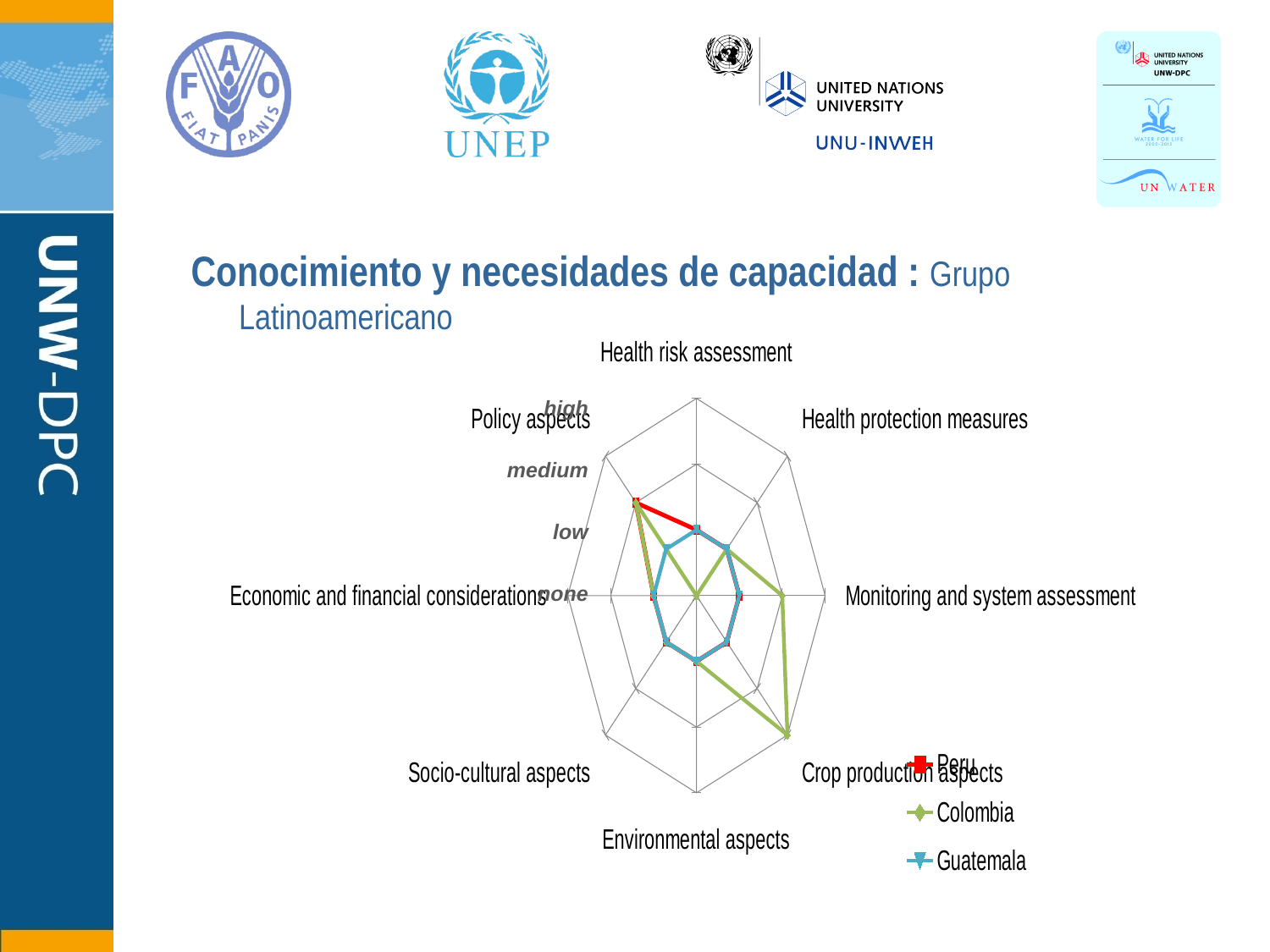
For Colombia, which category has the highest value? Crop production aspects Which countries are listed in the chart legend? Peru, Colombia, Guatemala Which category is plotted at the bottom of the radar chart? Environmental aspects How many categories (axes) does the radar chart have? 8 How many series does the chart legend list? 3 What kind of chart is shown on the slide? Radar chart Which category is plotted at the top of the radar chart? Health risk assessment On Monitoring and system assessment, which is larger: the value for Colombia or the value for Guatemala? Colombia On Policy aspects, which is larger: the value for Peru or the value for Guatemala? Peru On Crop production aspects, which is larger: the value for Colombia or the value for Guatemala? Colombia